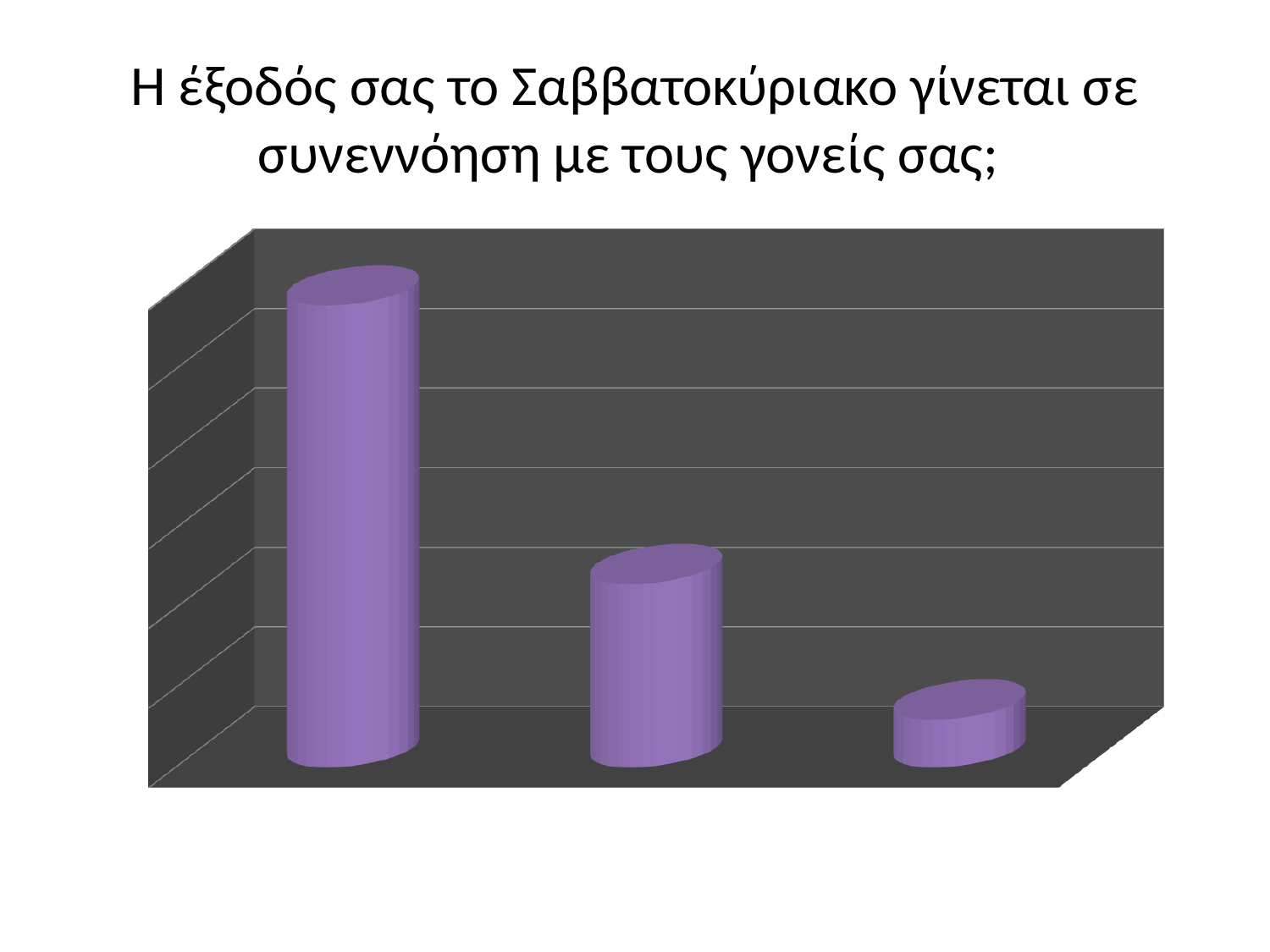
What kind of chart is shown on the slide? bar chart How many bars are plotted in the chart? 3 What colour are the bars in the chart? purple Which bar is the shortest: the left, middle, or right one? right Is the left bar taller or shorter than the middle bar? taller What is the title of the slide above the chart? Η έξοδός σας το Σαββατοκύριακο γίνεται σε συνεννόηση με τους γονείς σας; Do the bar heights rise or fall from left to right across the chart? fall Is the right bar taller or shorter than the middle bar? shorter Which bar is the tallest: the left, middle, or right one? left